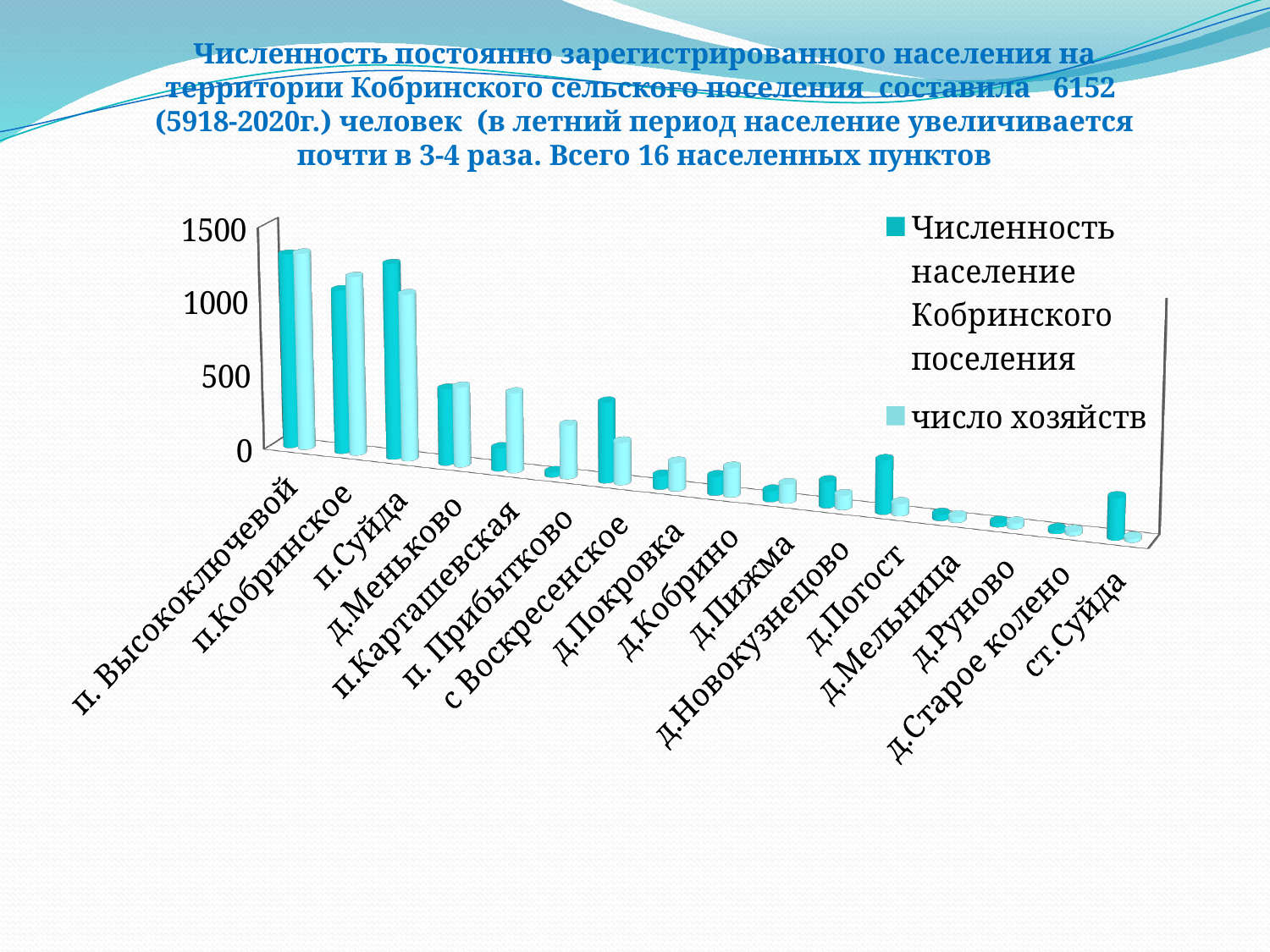
For с Воскресенское, which series has the larger value: Численность население or число хозяйств? Численность население Is the population value (Численность население) for д.Покровка greater or less than 500? less Do the population values (Численность население) generally rise or fall moving from left to right along the x axis? fall How many settlements (categories) are shown on the x axis of the chart? 16 Is the population value (Численность население) for п. Высокоключевой greater or less than 1000? greater Which has the larger population value (Численность население): п. Высокоключевой or д.Меньково? п. Высокоключевой How many series does the chart legend list? 2 What are the two series named in the chart legend? Численность население Кобринского поселения; число хозяйств Is the population value (Численность население) for п.Суйда greater or less than 1000? greater For п.Карташевская, which series has the larger value: Численность население or число хозяйств? число хозяйств What kind of chart is shown on the slide? bar chart